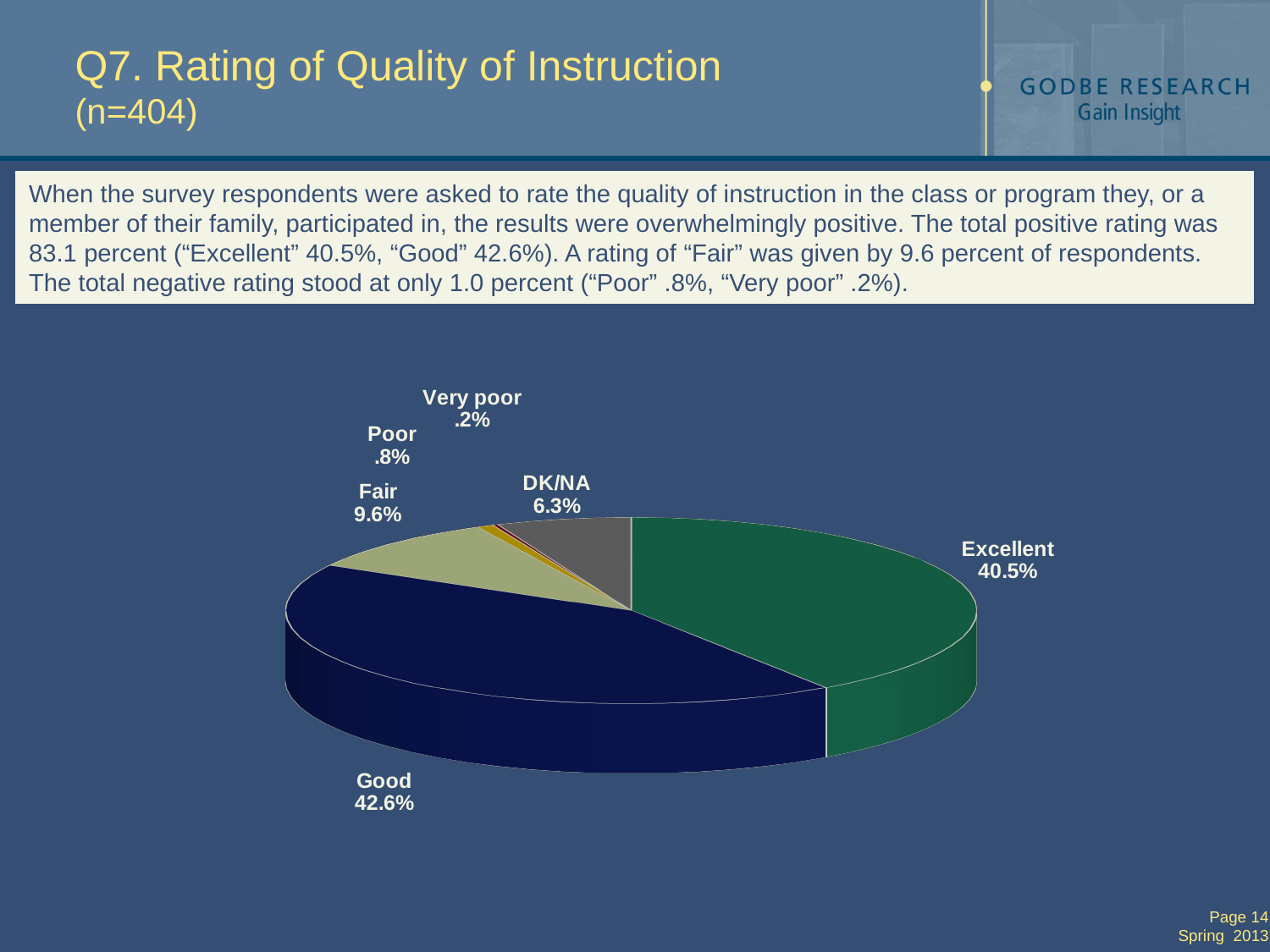
What percentage is shown for DK/NA? 6.3% Which rating category has the largest slice of the pie? Good What percentage of respondents rated the quality of instruction as Excellent? 40.5% What is the combined percentage of the Poor and Very poor slices? 1.0% What percentage of respondents rated the quality of instruction as Good? 42.6% Which is larger, the Fair slice or the DK/NA slice? Fair What share of the pie is labelled Fair? 9.6% Which rating category has the smallest slice of the pie? Very poor What kind of chart is shown on the slide? Pie chart What percentage is shown for Very poor? .2% How many categories are shown in the pie chart? 6 What is the difference between the Good and Excellent percentages? 2.1%